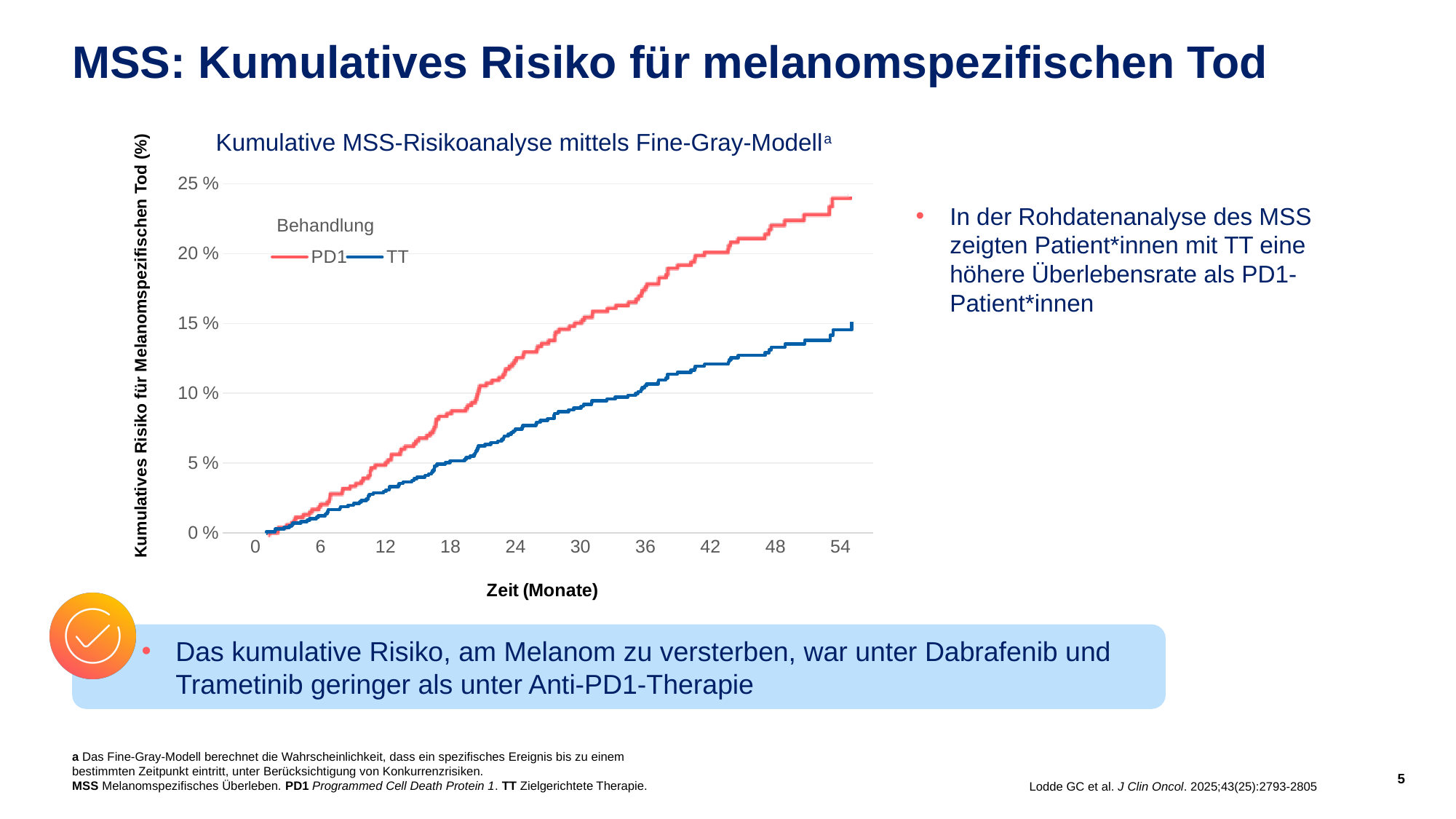
Is the value for PD1 at 54 months greater or less than 20 %? greater What is the label of the x axis? Zeit (Monate) Is the value for PD1 at 36 months greater or less than 15 %? greater Which treatment series is shown in red? PD1 What kind of chart is shown on the slide? line chart Do the values for PD1 rise or fall along the x axis? rise Which series has the higher cumulative risk at 54 months, PD1 or TT? PD1 Do the values for TT rise or fall along the x axis? rise Is the value for PD1 at 24 months greater or less than 10 %? greater How many series does the legend list? 2